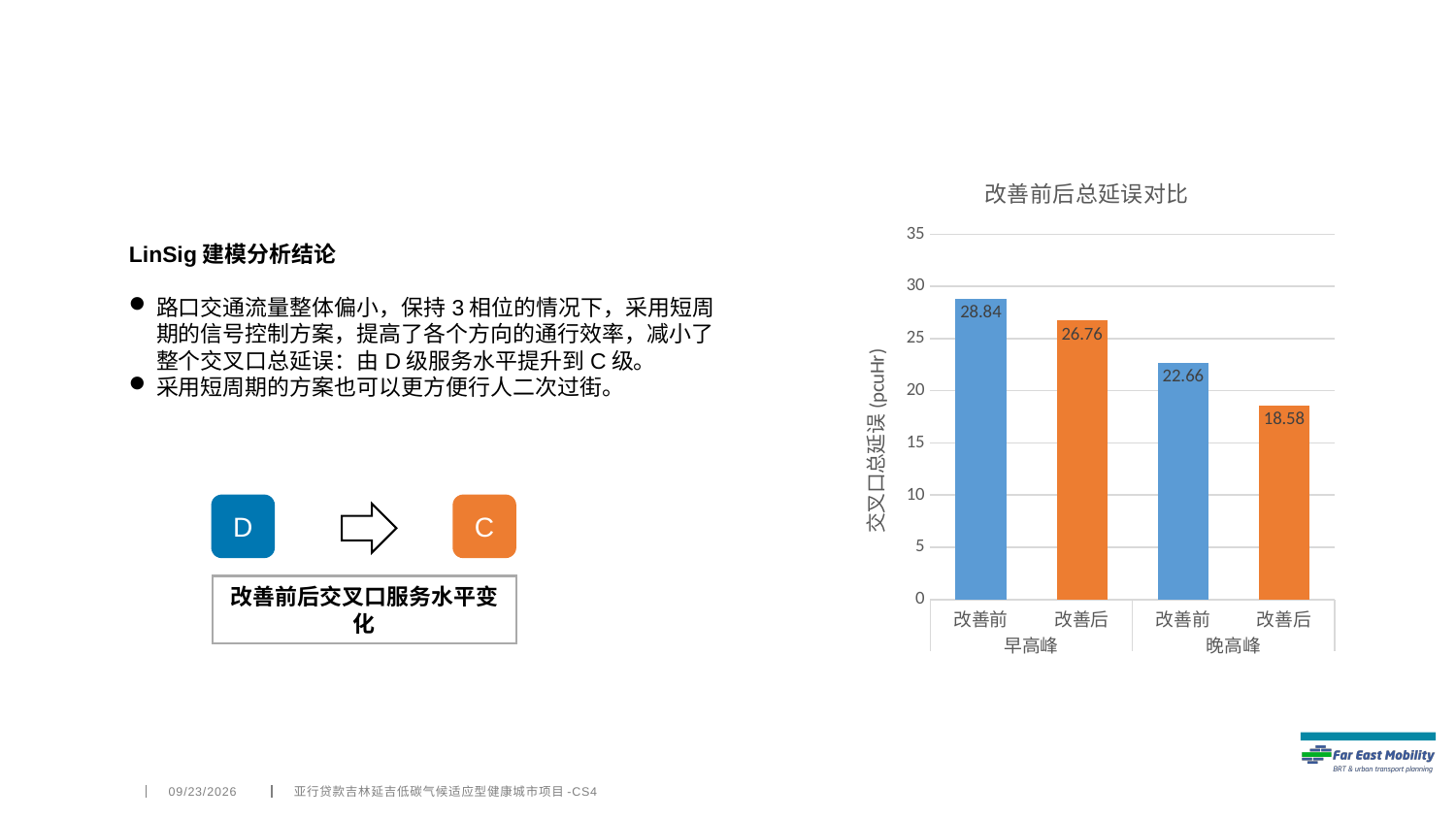
How many bars are plotted in the chart? 4 What is the difference between 改善前 and 改善后 in the 晚高峰 group? 4.08 What type of chart is shown on the slide? bar chart What is the total intersection delay for 改善前 in the 早高峰 group? 28.84 Is the value for 改善后 in the 晚高峰 group greater or less than 20? less What is the value of the 改善前 bar in the 晚高峰 group? 22.66 What is the total intersection delay for 改善后 in the 晚高峰 group? 18.58 What is the difference between 改善前 and 改善后 in the 早高峰 group? 2.08 What is the title of the chart? 改善前后总延误对比 Which bar has the highest value in the chart? 早高峰 改善前 Which bar has the lowest value in the chart? 晚高峰 改善后 Which is larger: 改善后 in 早高峰 or 改善前 in 晚高峰? 改善后 in 早高峰